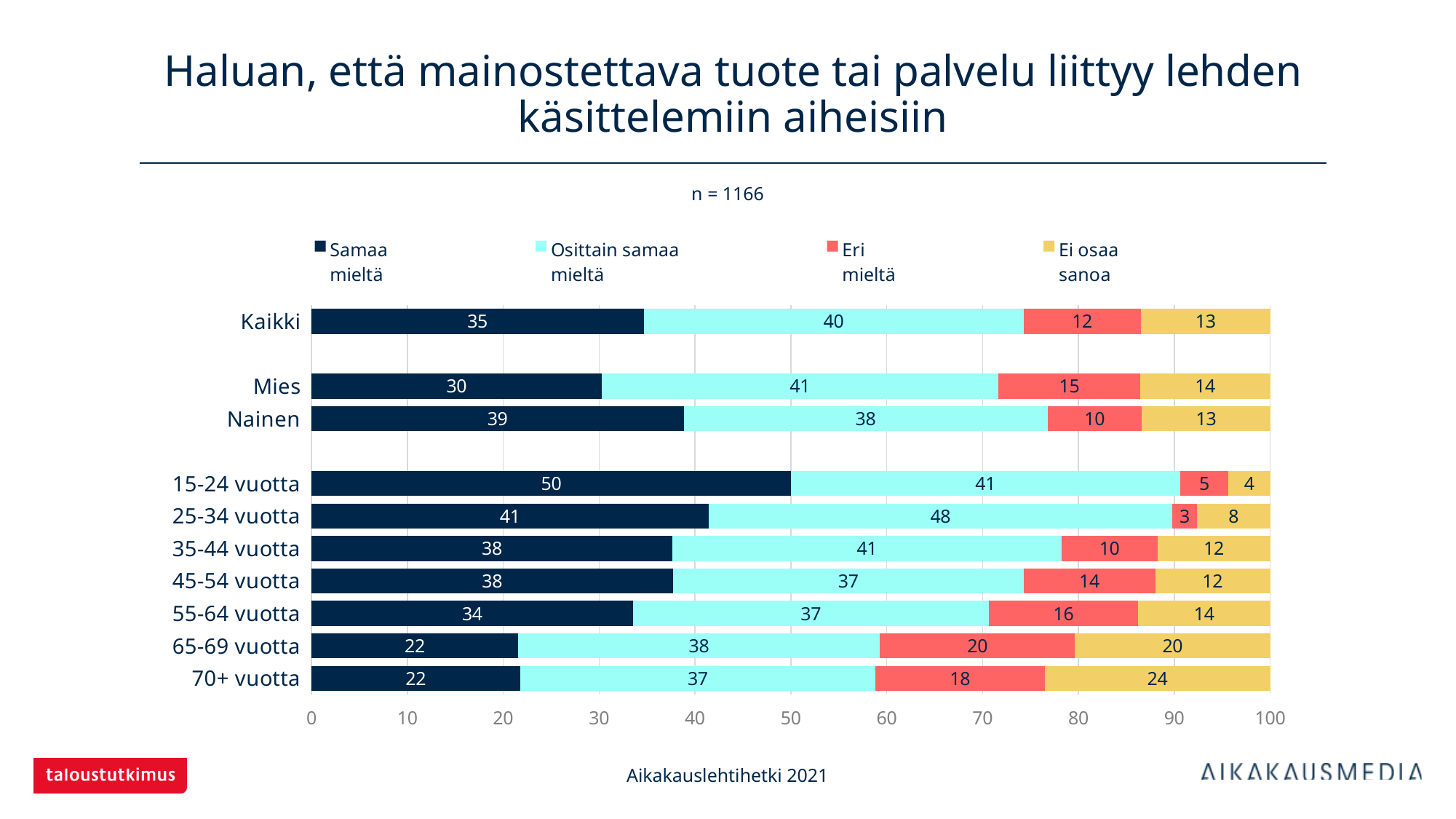
How many series does the legend list? 4 Which category has the highest 'Samaa mieltä' value? 15-24 vuotta What is the 'Samaa mieltä' value for Kaikki? 35 What is the total of the stacked bar for Mies? 100 What is the sample size (n) shown on the slide? n = 1166 What is the difference between the 'Samaa mieltä' values for Nainen and Mies? 9 What is the 'Ei osaa sanoa' value for 70+ vuotta? 24 Which has a larger 'Eri mieltä' value, 65-69 vuotta or 55-64 vuotta? 65-69 vuotta How many categories are plotted on the chart? 10 What is the 'Osittain samaa mieltä' value for 25-34 vuotta? 48 Which category has the lowest 'Eri mieltä' value? 25-34 vuotta What type of chart is shown on the slide? Stacked bar chart